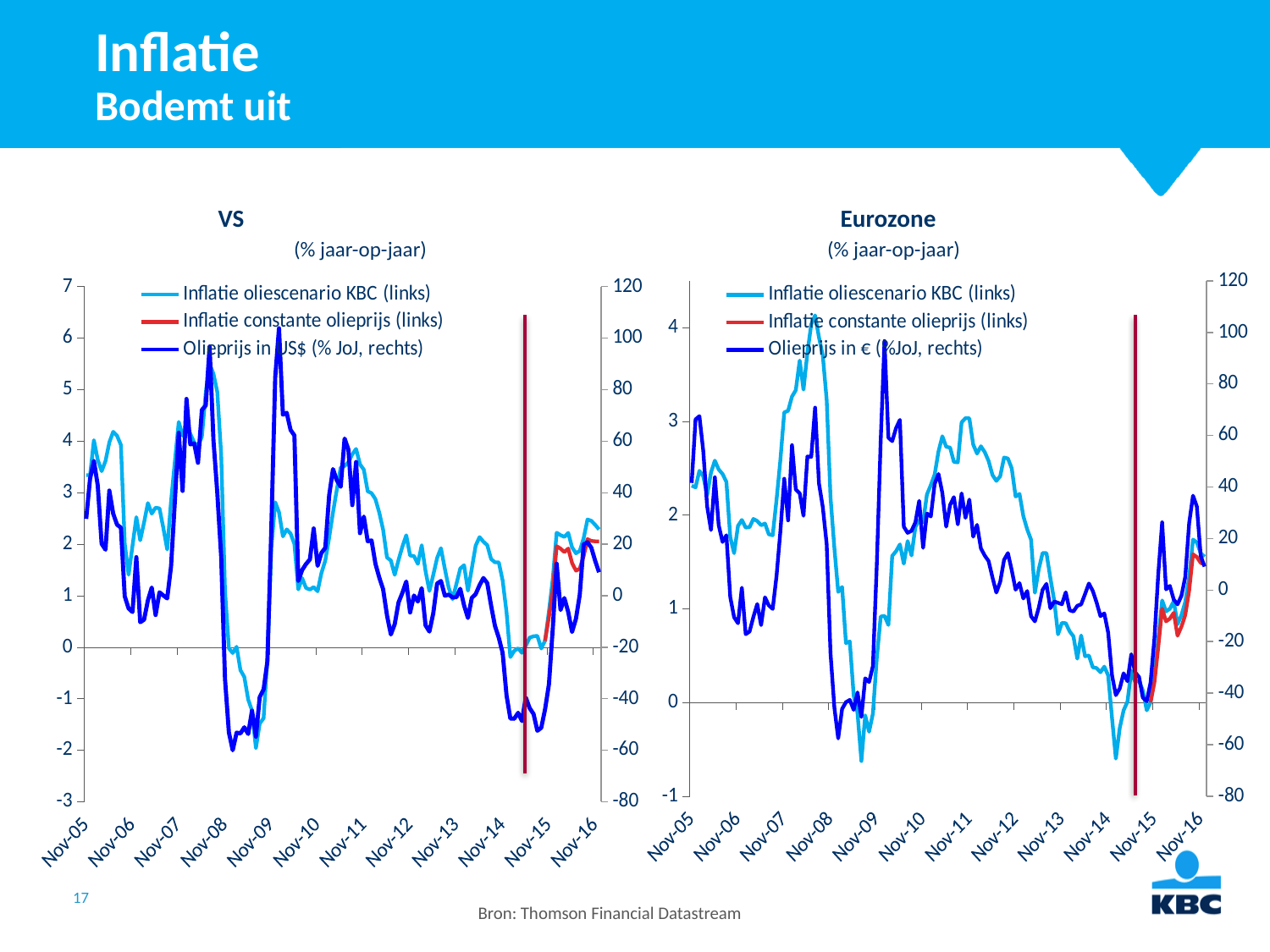
Which series in the Eurozone chart is drawn in red? Inflatie constante olieprijs (links) What is the title of the chart on the right side of the slide? Eurozone In the Eurozone chart, does the Inflatie oliescenario KBC (links) line rise or fall between Nov-11 and Nov-14? fall How many date labels are shown on the x axis of the VS chart? 12 How many series does the legend of the VS chart list? 3 What kind of chart is the VS chart? line chart In the VS chart, does the Inflatie oliescenario KBC (links) line rise or fall between Nov-14 and Nov-15? fall How many series does the legend of the Eurozone chart list? 3 In the Eurozone chart, is the value of Inflatie oliescenario KBC (links) around Nov-14 greater or less than 1? less